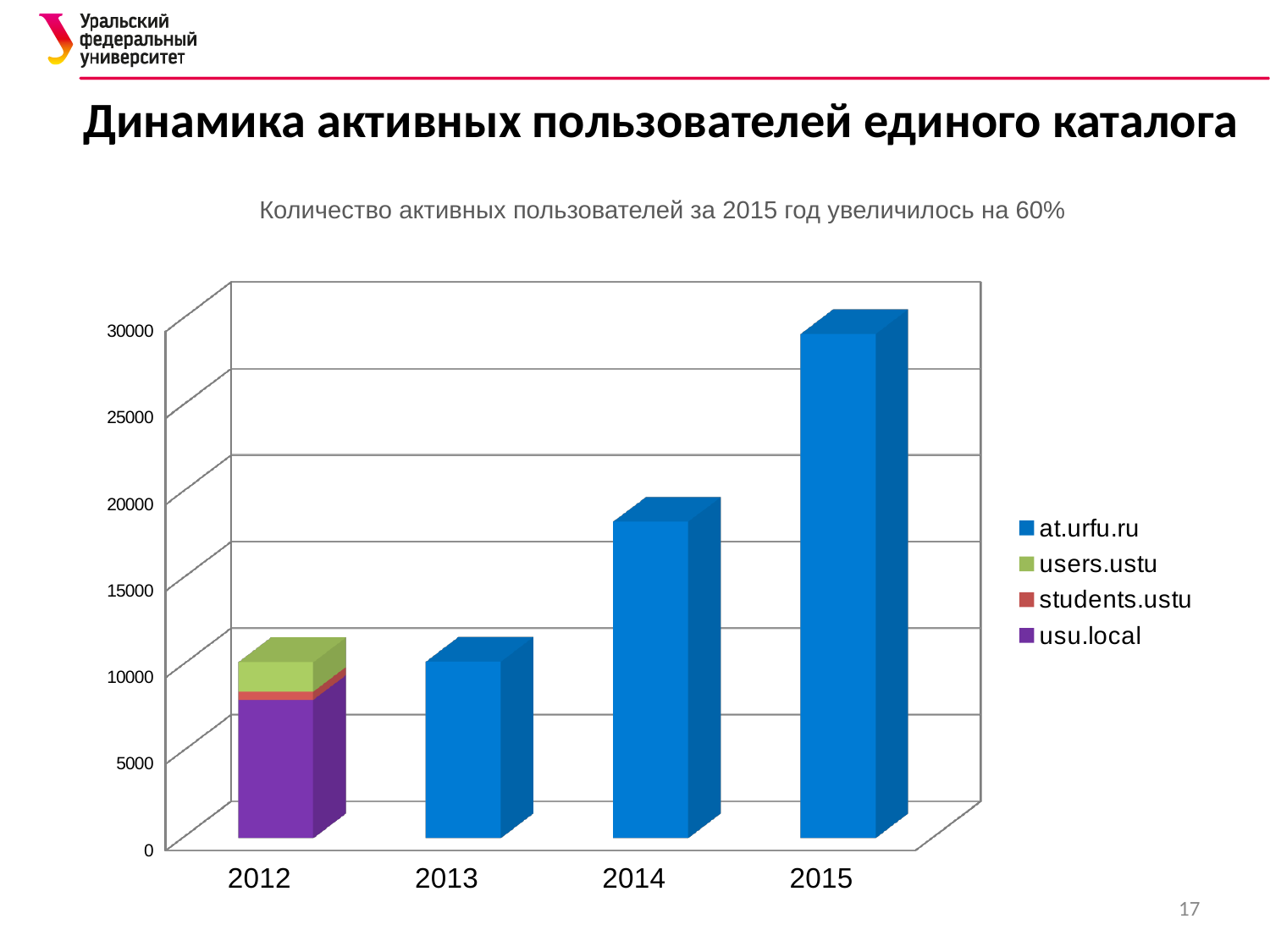
Which year has the highest bar in the chart? 2015 Which is larger, the bar for 2014 or the bar for 2015? 2015 Is the value for 2014 greater or less than 20000? less What kind of chart is shown on the slide? bar chart Which series is shown in purple in the chart legend? usu.local Which series is shown in blue in the chart legend? at.urfu.ru Do the values rise or fall from 2013 to 2015? rise How many years are shown on the x axis of the chart? 4 Is the value for 2014 greater or less than 15000? greater Is the value for 2015 greater or less than 25000? greater How many series does the chart legend list? 4